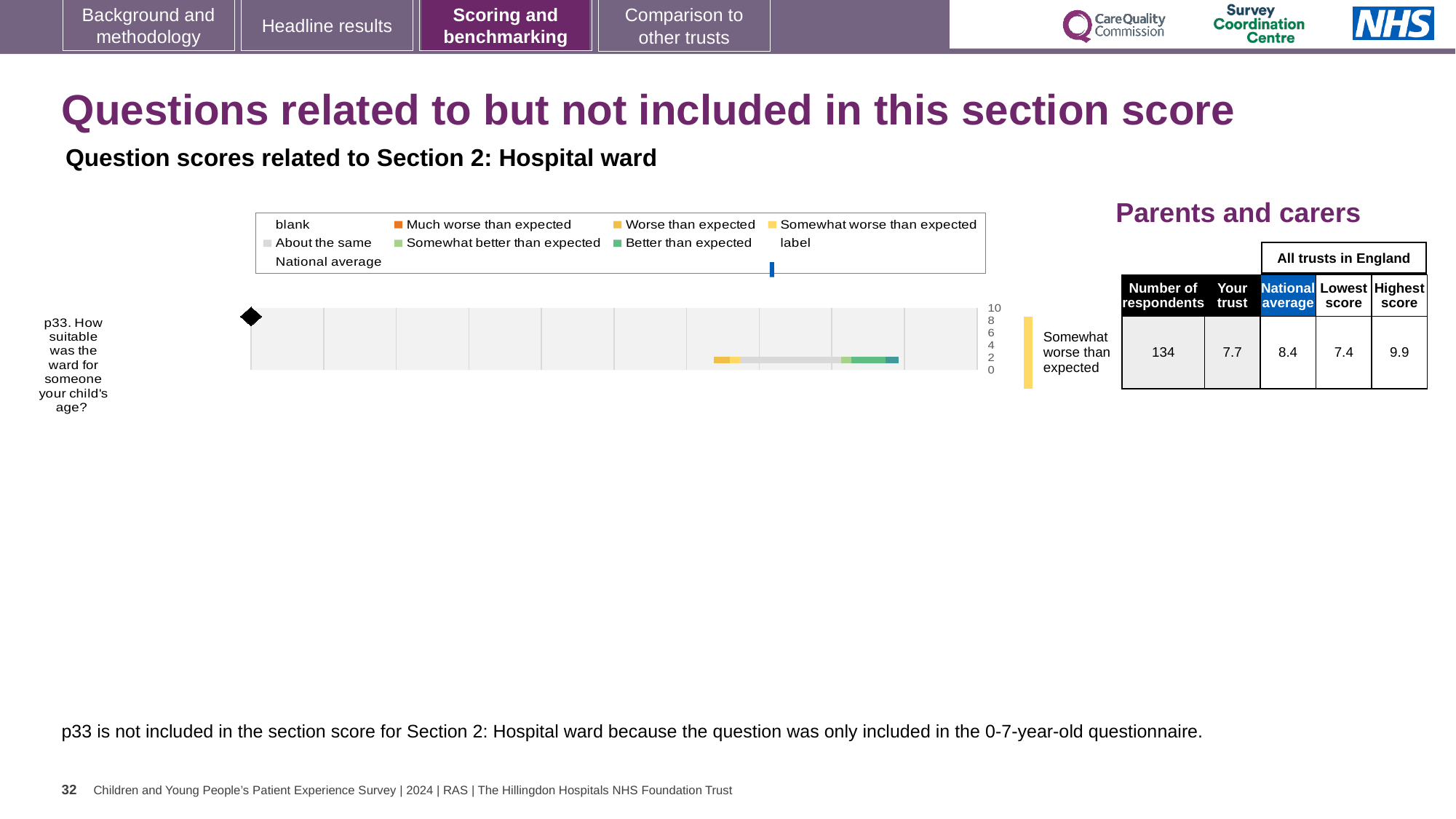
What is the lowest score among all trusts in England for p33? 7.4 By how much does the national average exceed the 'Your trust' score for p33? 0.7 What is the 'Your trust' score for p33? 7.7 What kind of chart is used to show the p33 question score? bar chart Which is larger for p33, the 'Your trust' score or the national average? National average What is the national average score for p33? 8.4 What is the highest score among all trusts in England for p33? 9.9 How many respondents answered p33? 134 How many survey questions are plotted in the chart? 1 What is the full label of the question plotted in the chart? p33. How suitable was the ward for someone your child's age? Which benchmark category is the trust's result for p33 labelled as? Somewhat worse than expected What is the difference between the highest and lowest scores for p33 across all trusts in England? 2.5